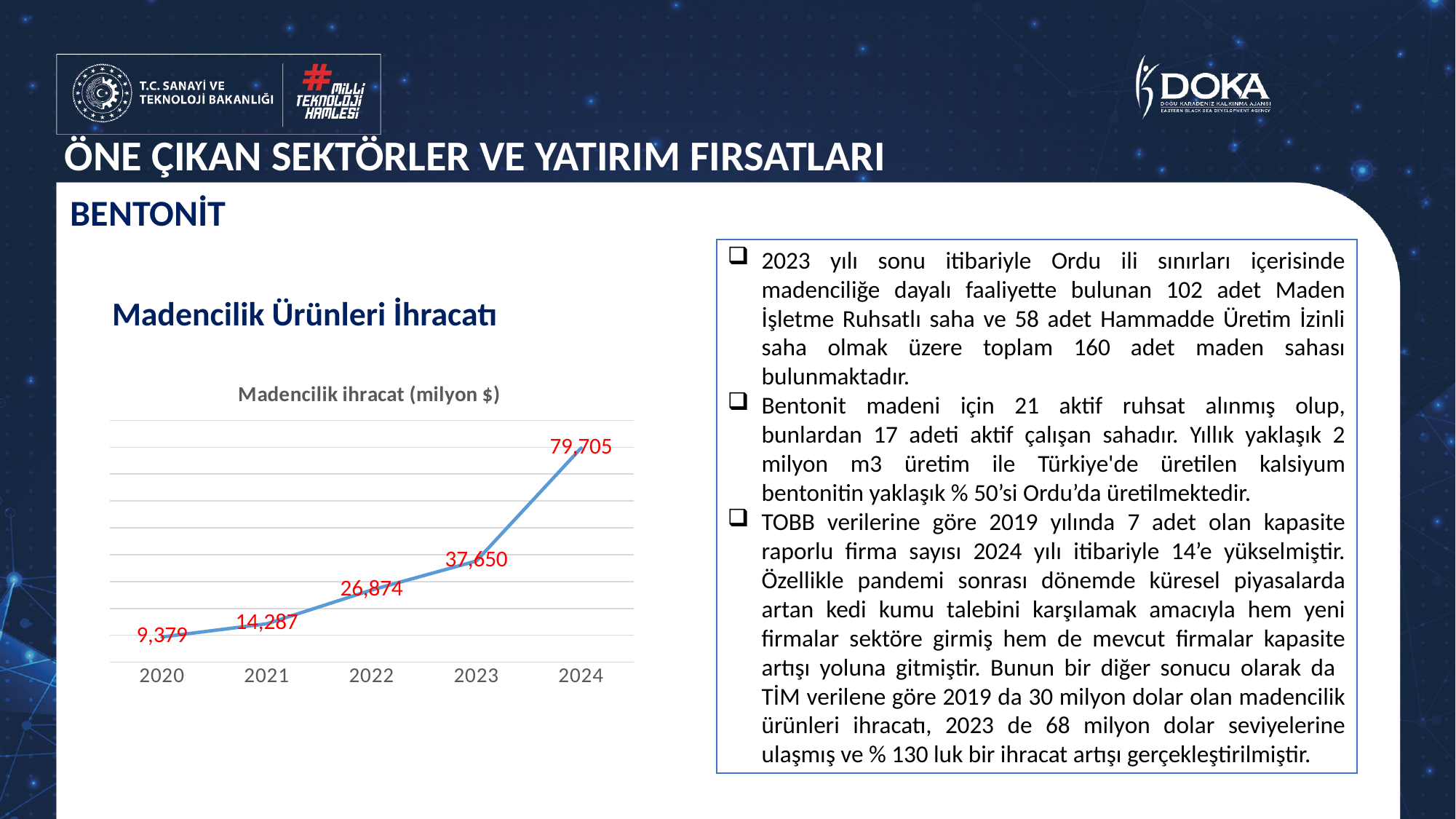
Which year has the lowest value in the Madencilik ihracat (milyon $) chart? 2020 What kind of chart is the Madencilik ihracat (milyon $) chart? Line chart What is the difference between the 2024 and 2023 values in the Madencilik ihracat (milyon $) chart? 42,055 Do the values in the Madencilik ihracat (milyon $) chart rise or fall from 2020 to 2024? Rise Which year has the highest value in the Madencilik ihracat (milyon $) chart? 2024 What is the value for 2022 in the Madencilik ihracat (milyon $) chart? 26,874 What is the value for 2024 in the Madencilik ihracat (milyon $) chart? 79,705 In the Madencilik ihracat (milyon $) chart, which is larger: the value for 2022 or the value for 2023? 2023 What is the difference between the 2021 and 2020 values in the Madencilik ihracat (milyon $) chart? 4,908 What is the title of the chart on the slide? Madencilik ihracat (milyon $) What is the value for 2020 in the Madencilik ihracat (milyon $) chart? 9,379 How many years are plotted in the Madencilik ihracat (milyon $) chart? 5